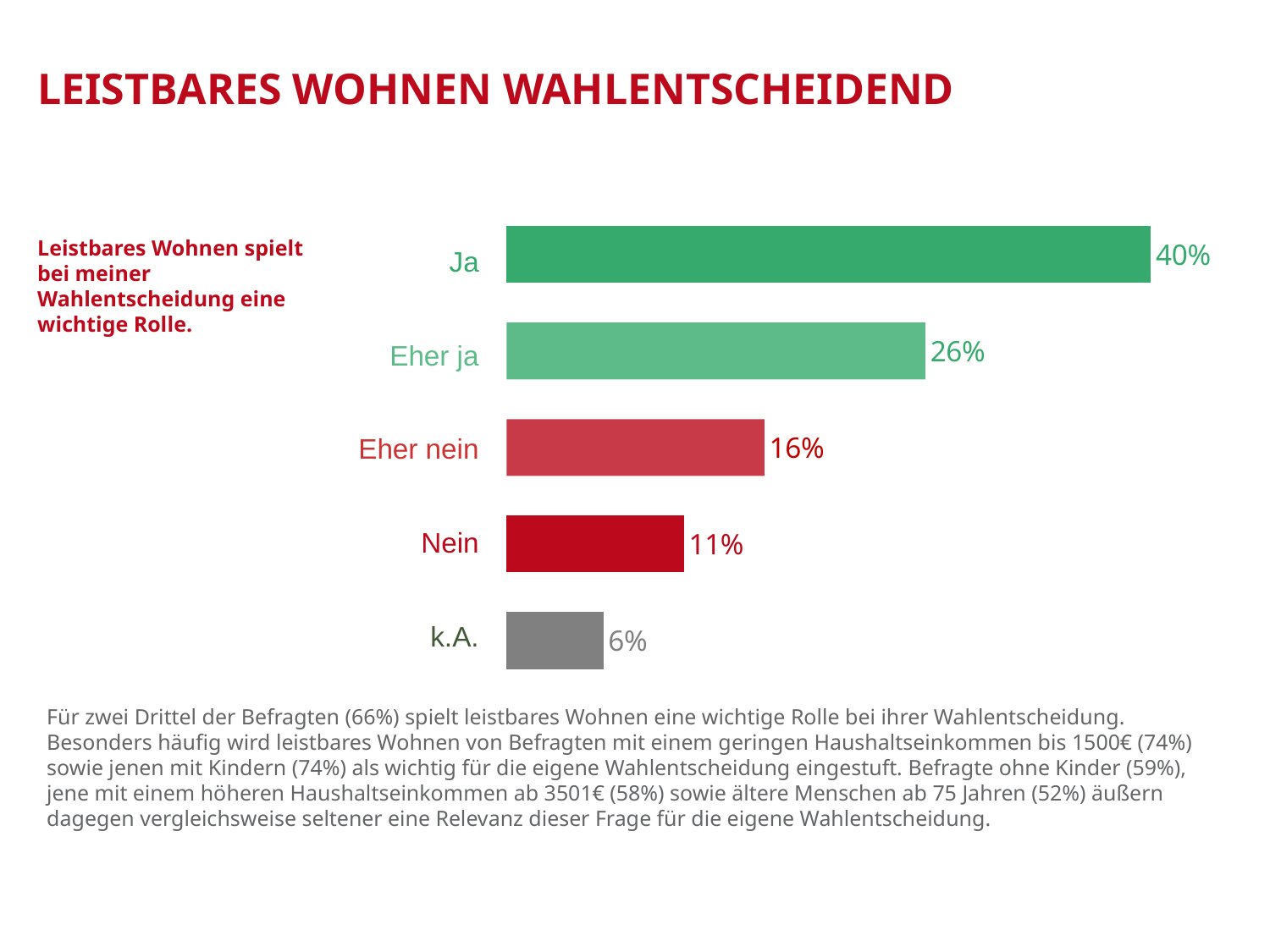
What is the difference between the values for "Ja" and "Eher ja"? 14% Which is larger, the value for "Eher ja" or the value for "Eher nein"? Eher ja What kind of chart is shown on the slide? Bar chart Which category has the highest value? Ja What is the difference between the values for "Eher nein" and "Nein"? 5% What is the value for "Eher ja"? 26% Which category has the lowest value? k.A. What is the value for "k.A."? 6% What is the value for "Ja"? 40% What is the value for "Eher nein"? 16% What is the value for "Nein"? 11% How many categories are shown in the chart? 5